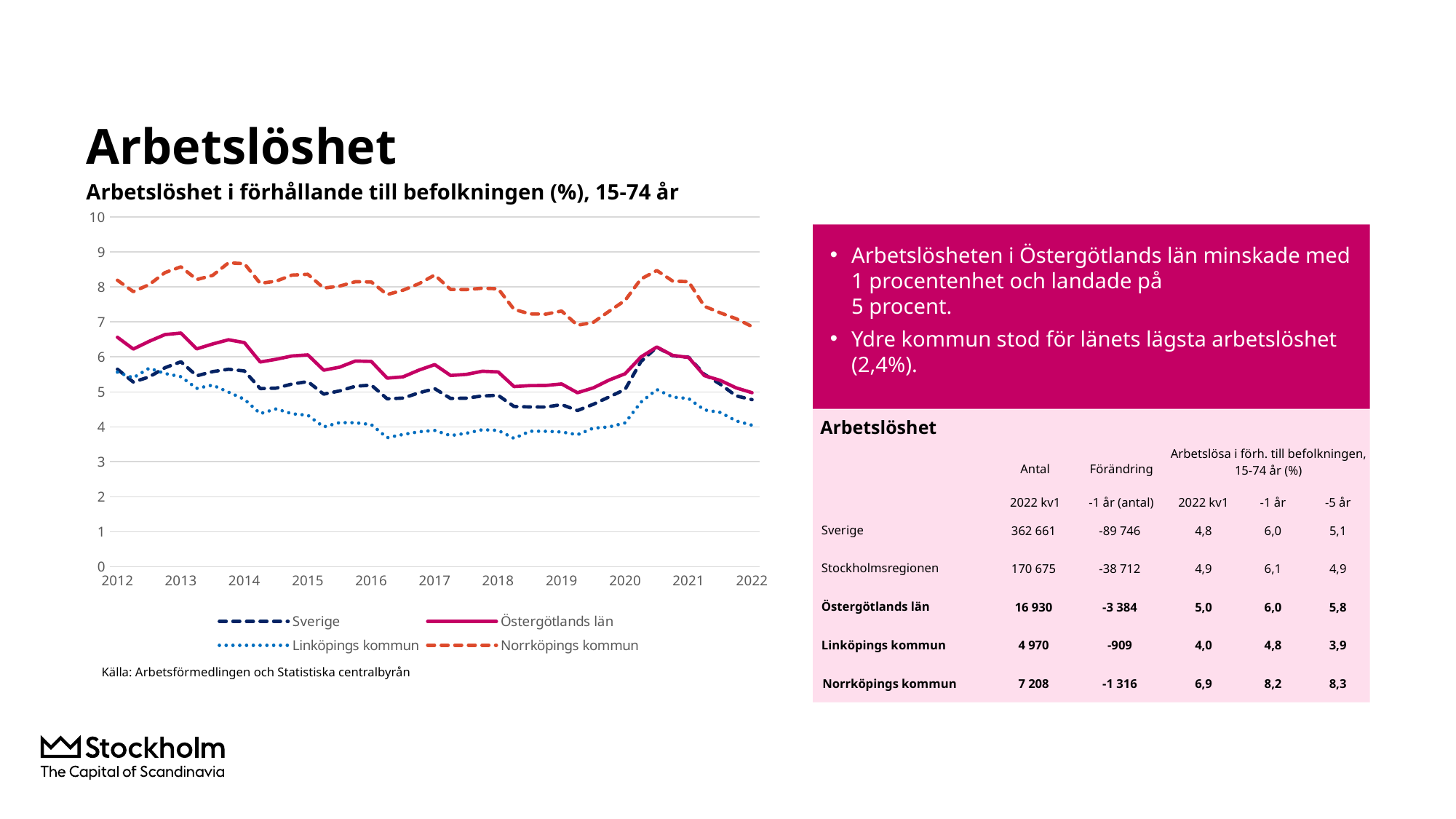
Is the value for Norrköpings kommun at the start of 2012 greater or less than 7? greater How many series does the chart legend list? 4 Does the Norrköpings kommun line overall rise or fall from 2012 to 2022? fall Which series are listed in the chart legend? Sverige, Östergötlands län, Linköpings kommun, Norrköpings kommun What kind of chart is shown on the slide? line chart Is the value for Sverige at 2016 greater or less than 6? less Is the value for Linköpings kommun at 2022 greater or less than 5? less At 2016, which series has the higher value: Norrköpings kommun or Linköpings kommun? Norrköpings kommun Which series has the highest values across the whole period shown? Norrköpings kommun Which series has the lowest value at 2022? Linköpings kommun What is the title of the chart? Arbetslöshet i förhållande till befolkningen (%), 15-74 år